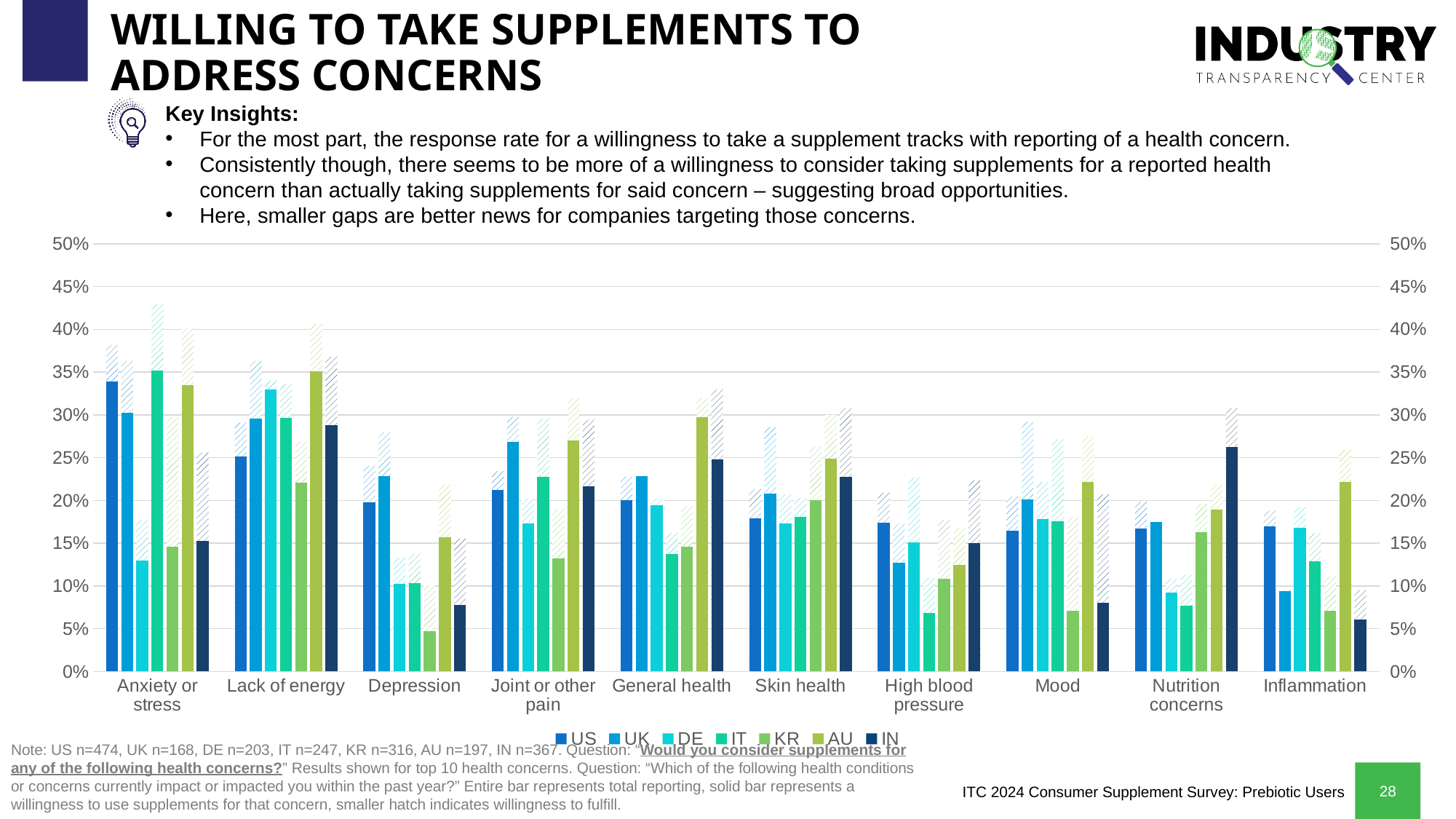
How many health concern categories are shown on the x axis? 10 How many series does the legend list? 7 Is the solid bar value for AU under General health greater or less than 25%? greater Which country has the highest solid bar under Nutrition concerns? IN Under Inflammation, which solid bar is larger, AU or IN? AU Is the solid bar value for IT under High blood pressure greater or less than 10%? less Is the solid bar value for US under Anxiety or stress greater or less than 30%? greater Which country has the lowest solid bar under Depression? KR What is the highest value shown on the vertical axis? 50% What kind of chart is shown on the slide? bar chart